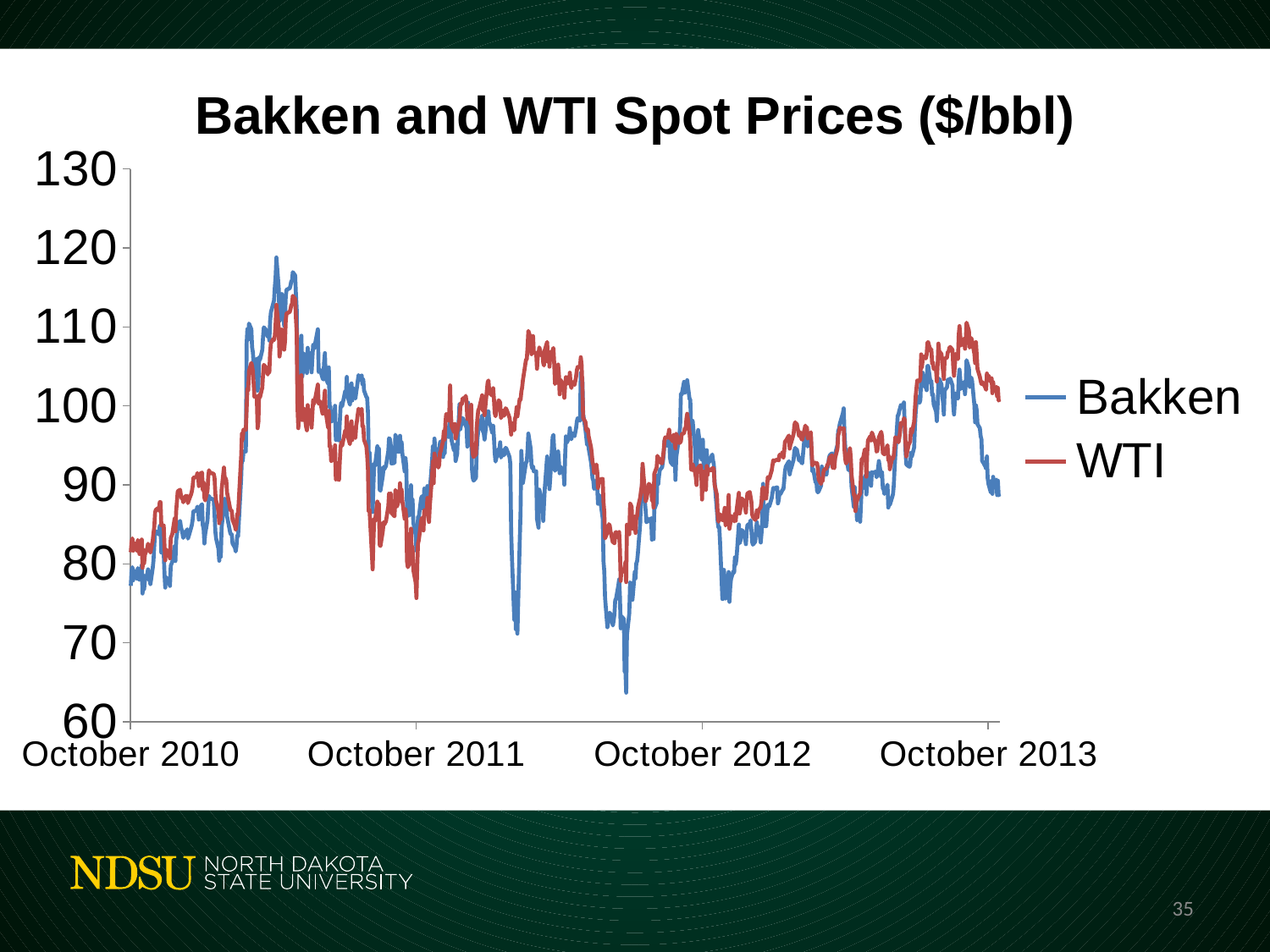
Is the highest value reached by the Bakken series greater or less than 110? greater Is the lowest value reached by the WTI series greater or less than 80? less Is the lowest value reached by the Bakken series greater or less than 70? less Do the Bakken prices rise or fall between October 2010 and their peak in early 2011? rise How many series does the legend list? 2 How many date labels are shown on the x axis? 4 At the end of the series (around October 2013), which is higher, Bakken or WTI? WTI Which colour is used for the WTI series? red What kind of chart is shown on the slide? line chart Which series drops to the lowest value anywhere on the chart? Bakken What is the title of the chart? Bakken and WTI Spot Prices ($/bbl)